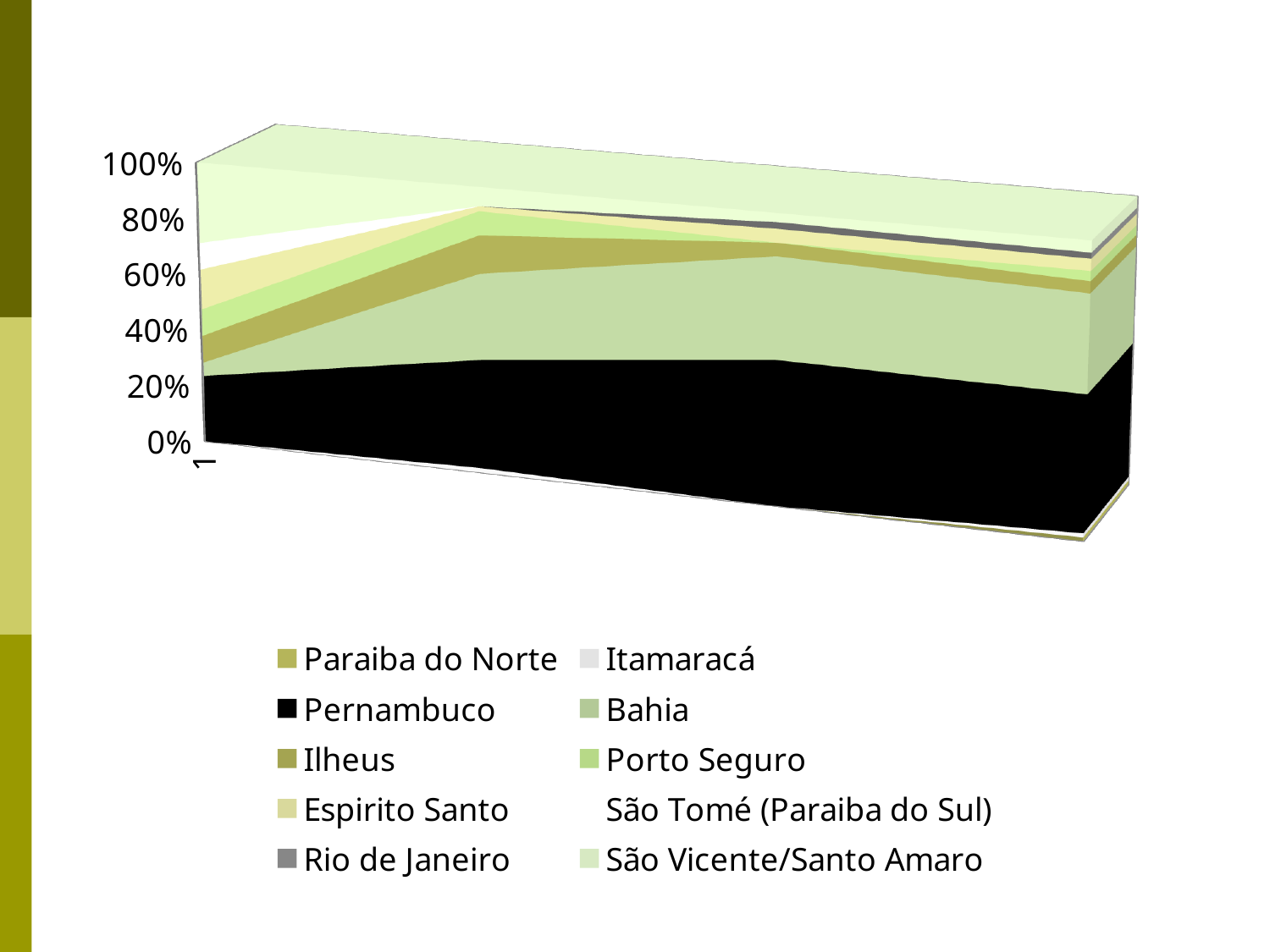
Which series is shown in black in the legend? Pernambuco Which series forms the bottom layer of the stacked area chart? Pernambuco Is the share for Pernambuco at the right edge of the chart greater or less than 40%? greater What is the highest value shown on the vertical axis? 100% How many series does the legend list? 10 What kind of chart is shown on the slide? Area chart Which legend entry is listed directly after Ilheus? Porto Seguro Is the share for Pernambuco at the left edge of the chart greater or less than 40%? less Does the Pernambuco layer rise or fall between the middle of the chart and the right edge? fall What is the lowest value shown on the vertical axis? 0%